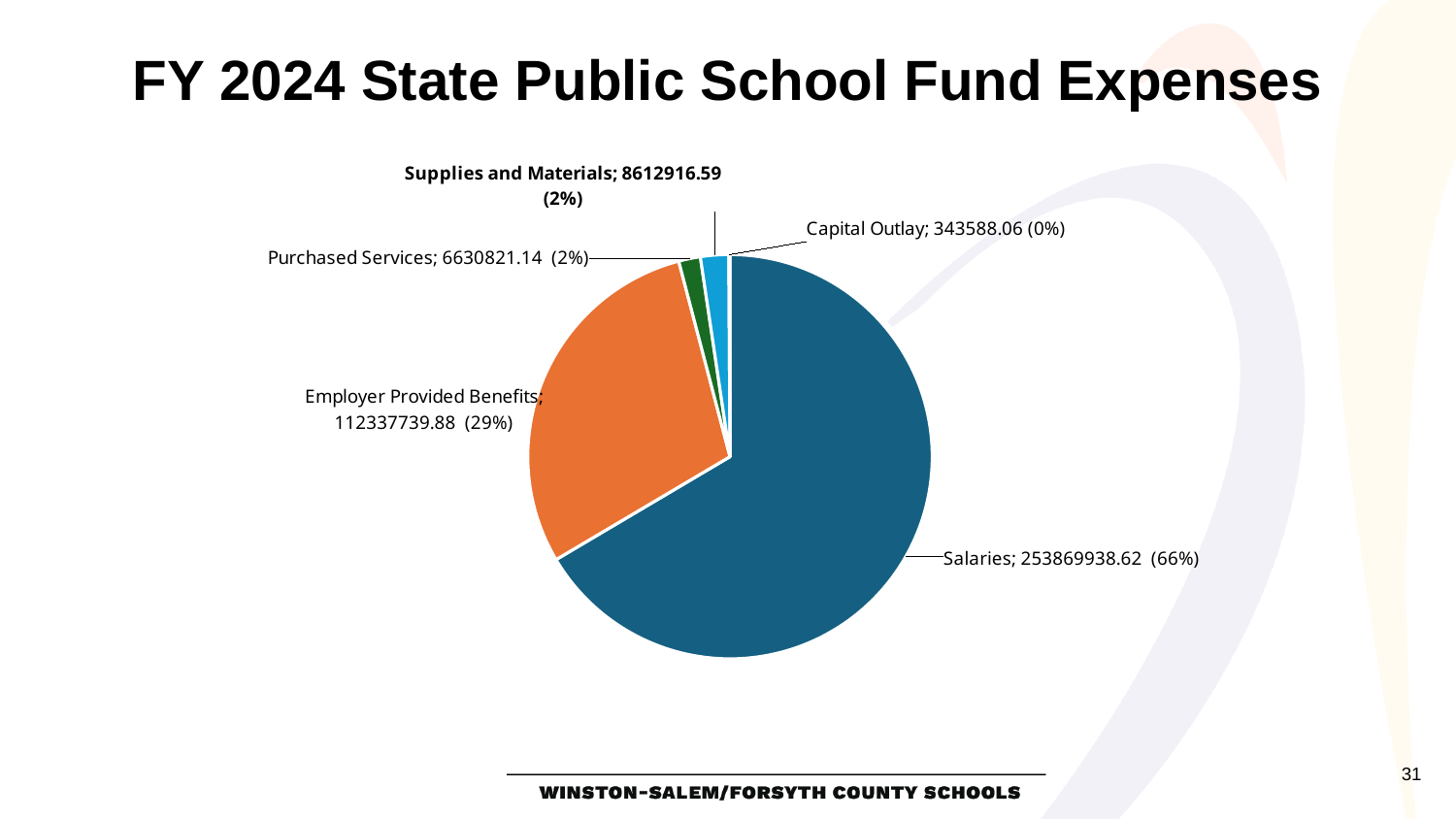
What is the value for Capital Outlay? 343588.06 What is the title of the chart on the slide? FY 2024 State Public School Fund Expenses Which category has the largest share of the pie? Salaries What is the value for Salaries? 253869938.62 What type of chart is shown on the slide? Pie chart What share of the pie does Employer Provided Benefits represent? 29% Which category has the smallest share of the pie? Capital Outlay Which is larger, Supplies and Materials or Purchased Services? Supplies and Materials What is the difference between the values for Salaries and Employer Provided Benefits? 141532198.74 What is the value for Employer Provided Benefits? 112337739.88 What is the value for Purchased Services? 6630821.14 How many categories (slices) does the pie chart show? 5